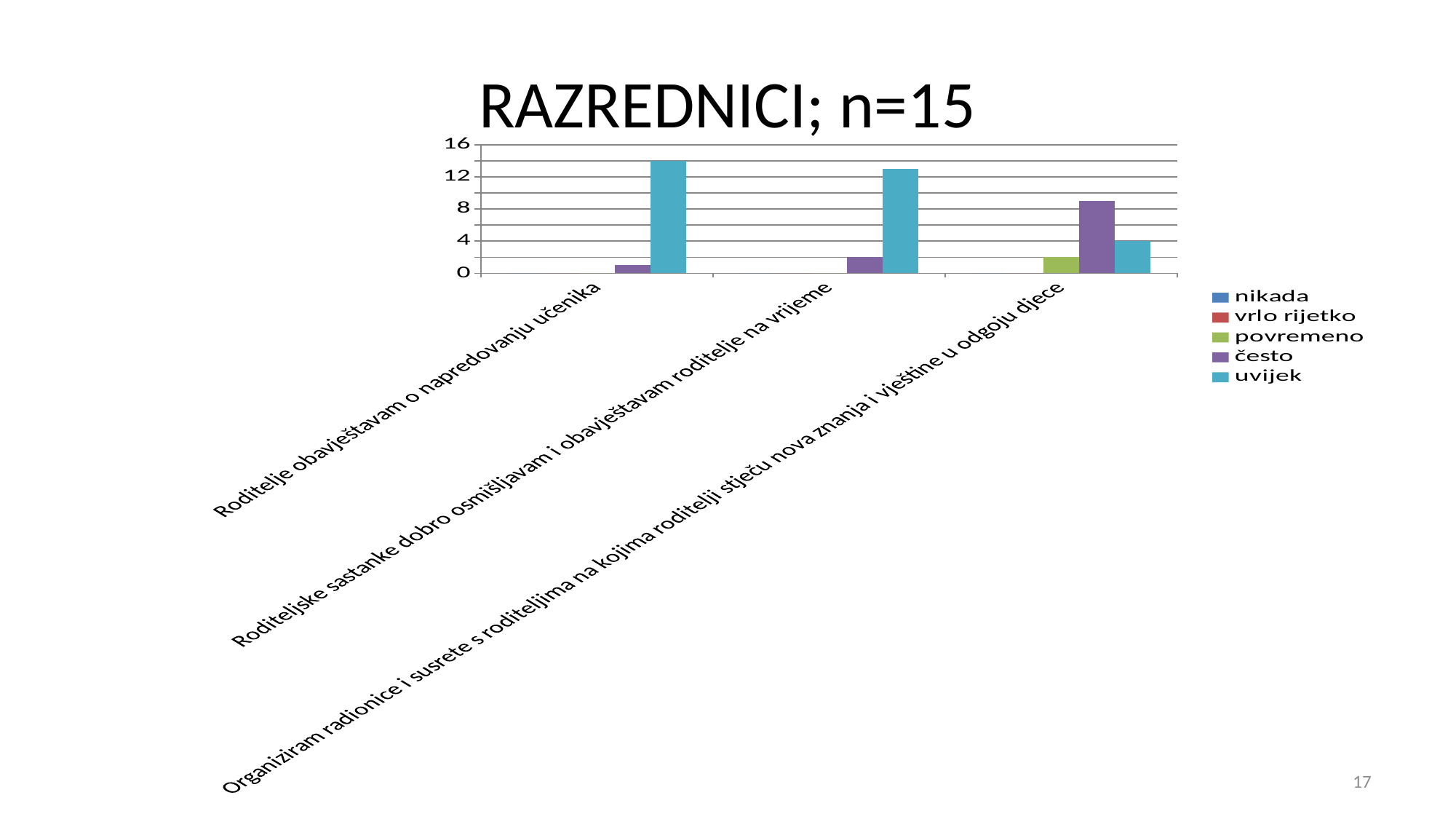
What is the title of the slide? RAZREDNICI; n=15 Which category has the highest value for 'uvijek'? Roditelje obavještavam o napredovanju učenika Is the value for 'uvijek' in the category 'Roditelje obavještavam o napredovanju učenika' greater or less than 12? greater Is the value for 'često' in the category 'Organiziram radionice i susrete s roditeljima na kojima roditelji stječu nova znanja i vještine u odgoju djece' greater or less than 8? greater In the category 'Organiziram radionice i susrete s roditeljima na kojima roditelji stječu nova znanja i vještine u odgoju djece', which is larger: 'često' or 'uvijek'? često What is the last entry in the legend? uvijek How many categories are shown on the x axis? 3 Is the value for 'uvijek' in the category 'Organiziram radionice i susrete s roditeljima na kojima roditelji stječu nova znanja i vještine u odgoju djece' greater or less than 8? less Which category has the lowest value for 'uvijek'? Organiziram radionice i susrete s roditeljima na kojima roditelji stječu nova znanja i vještine u odgoju djece What kind of chart is shown on the slide? bar chart How many series does the legend list? 5